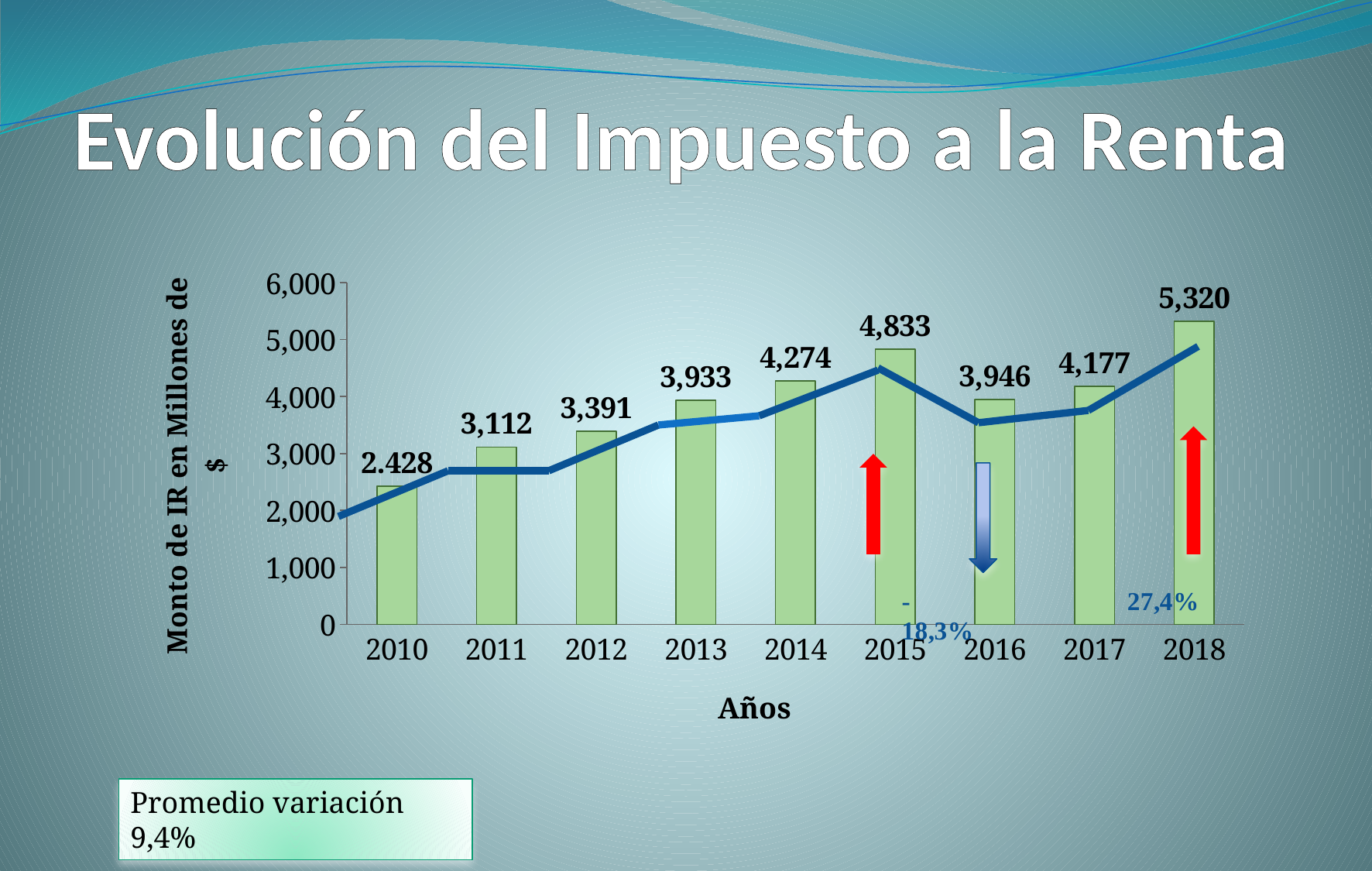
How many years are shown on the x axis? 9 What is the value for 2016? 3,946 Is the value for 2013 greater or less than 4,000? less Which year has the lowest value? 2010 What is the value for 2015? 4,833 Do the values rise or fall from 2010 to 2015? rise What is the difference between the values for 2018 and 2015? 487 What is the difference between the values for 2015 and 2016? 887 Which year has the highest value? 2018 What is the value for 2012? 3,391 What is the value for 2018? 5,320 Which is larger, the value for 2014 or the value for 2017? 2014